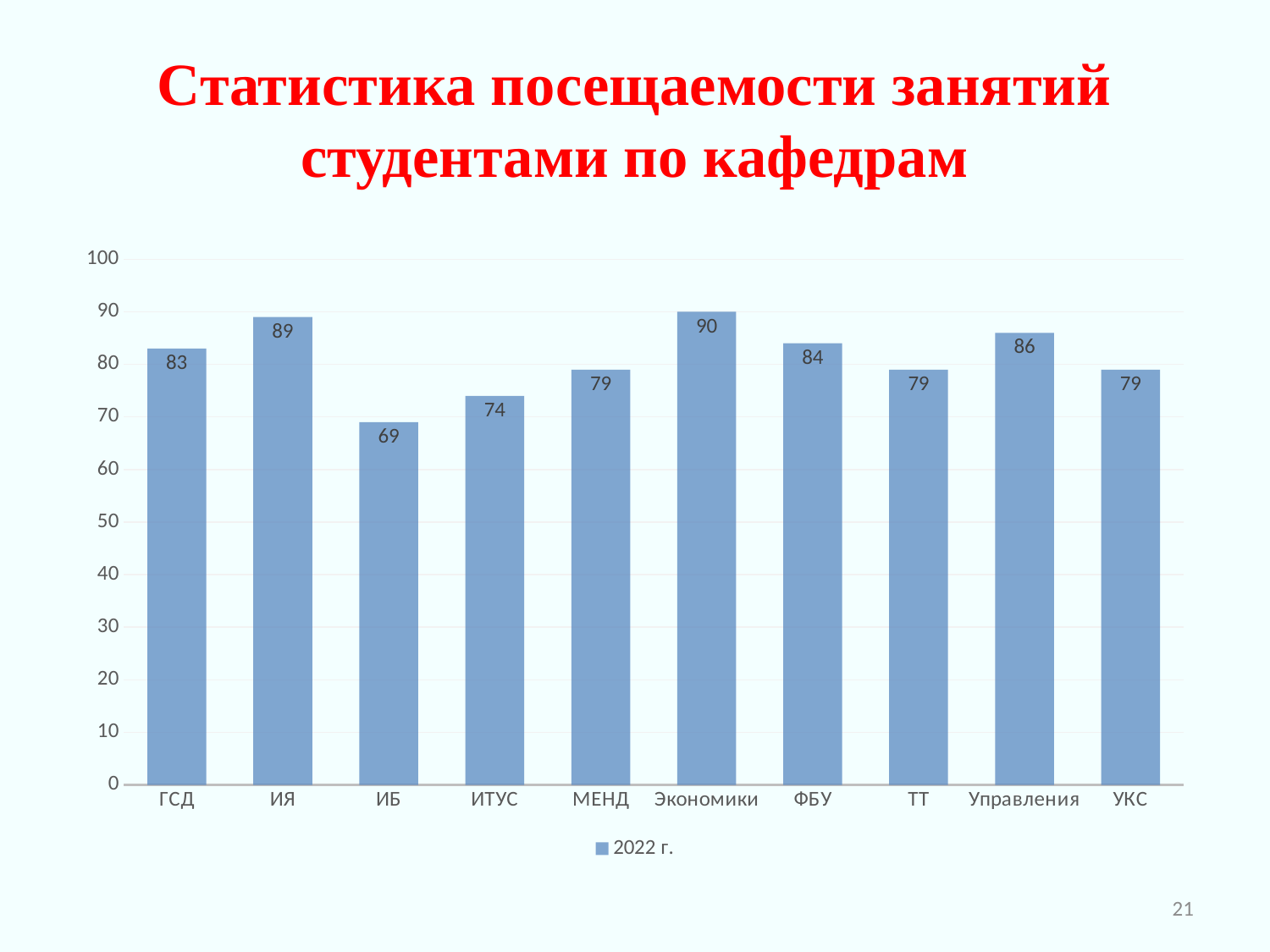
What is the difference between the values for ИЯ and ИБ? 20 What kind of chart is shown on the slide? bar chart Which category has the highest value? Экономики How many series does the legend list? 1 Is the value for ИБ greater or less than 70? less How many categories are shown on the x axis? 10 What is the value for ИТУС? 74 What is the value for Экономики? 90 What is the legend entry for the series? 2022 г. Which category has the lowest value? ИБ Which is larger, the value for ФБУ or the value for Управления? Управления What is the value for ГСД? 83